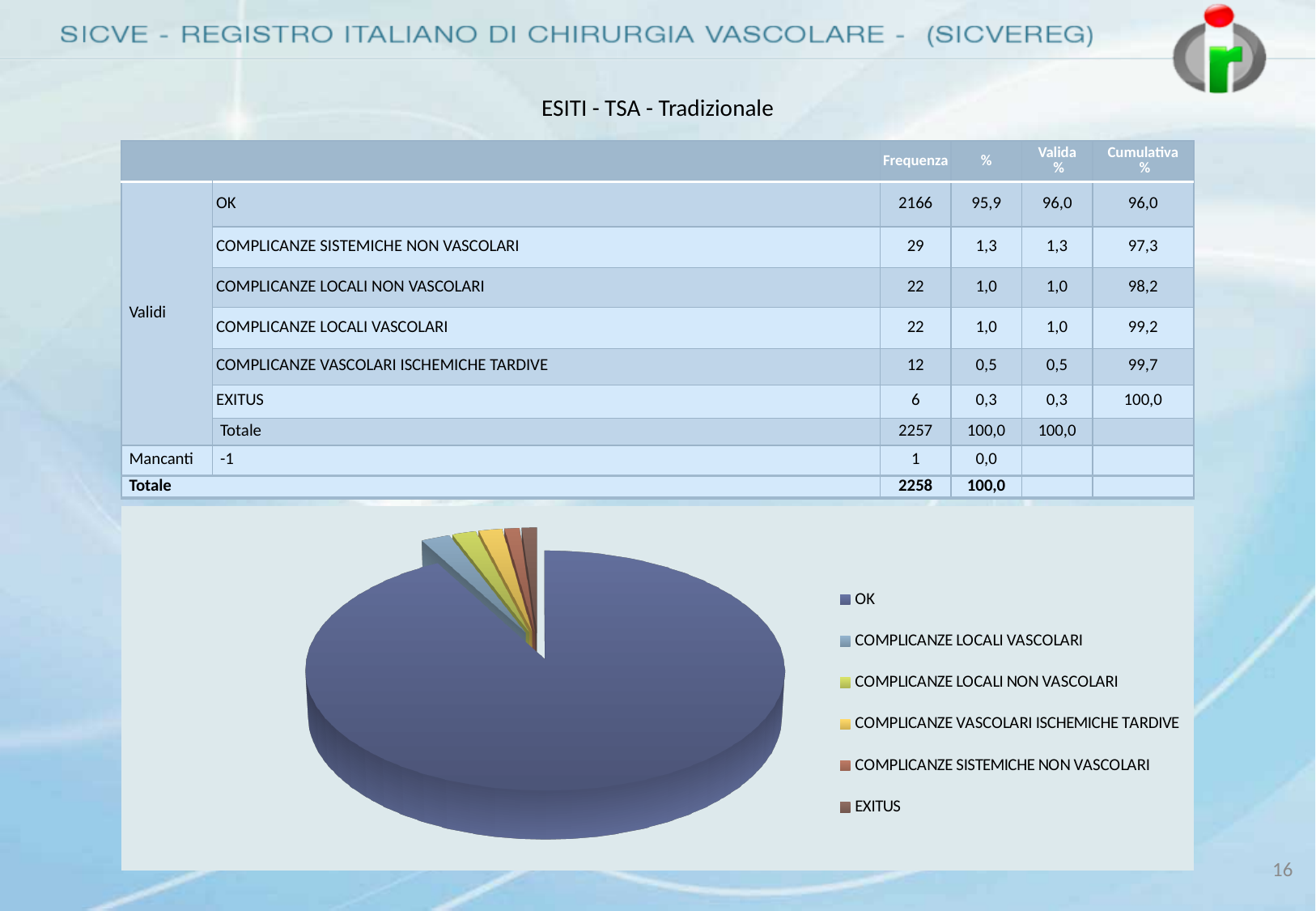
According to the table, what is the Frequenza for EXITUS? 6 What kind of chart is shown on the slide? pie chart According to the table, what is the total Frequenza of the valid cases (Totale under Validi)? 2257 According to the table, what is the difference in Frequenza between COMPLICANZE SISTEMICHE NON VASCOLARI and COMPLICANZE VASCOLARI ISCHEMICHE TARDIVE? 17 According to the table, what percentage (%) does OK represent? 95,9 According to the table, what is the Frequenza for COMPLICANZE SISTEMICHE NON VASCOLARI? 29 Which is larger in the pie chart, the slice for OK or the slice for EXITUS? OK Which category has the largest slice in the pie chart? OK What is the title shown above the table and chart on the slide? ESITI - TSA - Tradizionale Which legend entry is listed last in the pie chart's legend? EXITUS According to the table, what is the Frequenza for OK? 2166 How many categories does the pie chart's legend list? 6